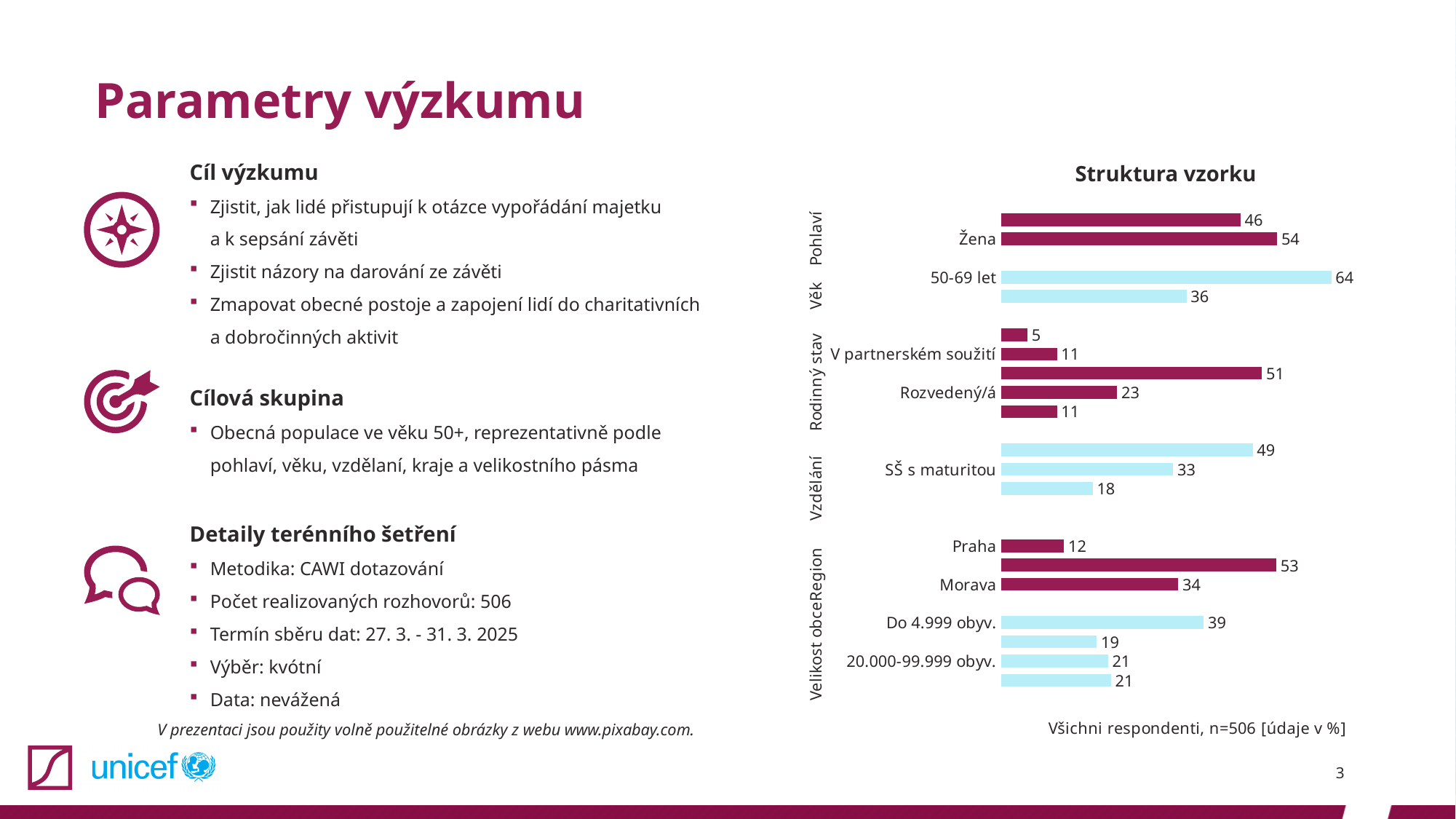
What is the title of the chart on the slide? Struktura vzorku Which has a larger value in the Struktura vzorku chart, Žena or Morava? Žena What is the value for Praha in the Struktura vzorku chart? 12 What is the value for Do 4.999 obyv. in the Struktura vzorku chart? 39 What is the difference between the values for 50-69 let and SŠ s maturitou in the Struktura vzorku chart? 31 What is the value for Rozvedený/á in the Struktura vzorku chart? 23 Which labelled category has the highest value in the Struktura vzorku chart? 50-69 let What is the value for SŠ s maturitou in the Struktura vzorku chart? 33 What is the difference between the values for Morava and Praha in the Struktura vzorku chart? 22 What is the value for Žena in the Struktura vzorku chart? 54 What kind of chart is Struktura vzorku? Bar chart What is the value for 50-69 let in the Struktura vzorku chart? 64